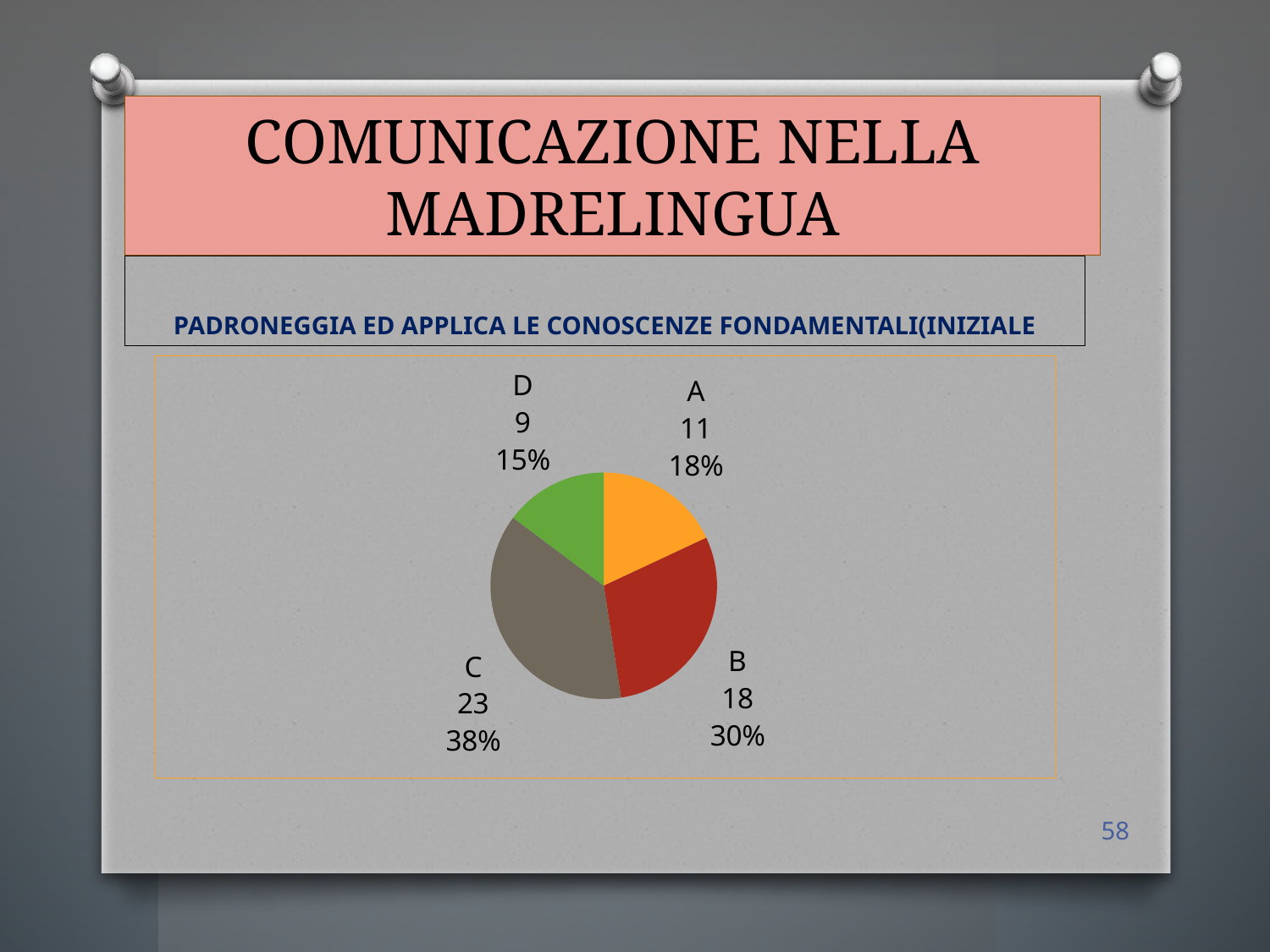
What kind of chart is shown on the slide? pie chart What colour is the slice for category C? grey-brown Which is larger, the value for A or the value for D? A How many categories are shown in the pie chart? 4 What percentage share does category A have? 18% What is the value for category C? 23 What is the value for category D? 9 Which category has the smallest slice? D What percentage share does category B have? 30% What is the total of all the values shown in the pie chart? 61 What is the difference between the values for C and B? 5 Which category has the largest slice? C